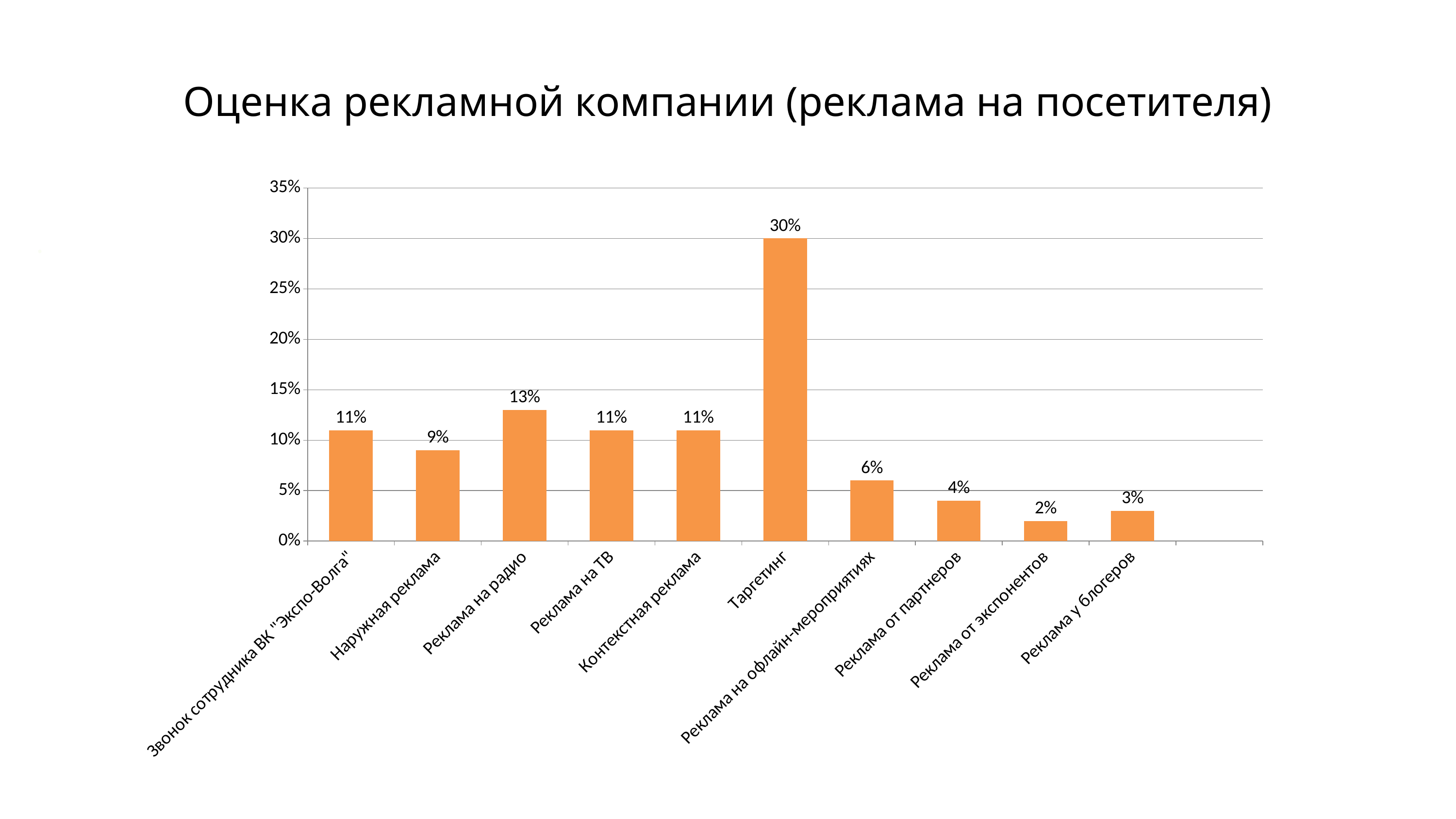
What is the value for Реклама на радио? 13% What is the value for Таргетинг? 30% Which is larger, the value for Реклама на офлайн-мероприятиях or the value for Реклама у блогеров? Реклама на офлайн-мероприятиях What kind of chart is shown on the slide? bar chart What is the title of the chart? Оценка рекламной компании (реклама на посетителя) Which category has the highest value? Таргетинг Is the value for Таргетинг greater or less than 25%? greater Which category has the lowest value? Реклама от экспонентов What is the value for Реклама от экспонентов? 2% How many categories are shown on the chart? 10 What is the value for Наружная реклама? 9% What is the difference between the values for Таргетинг and Реклама на радио? 17%